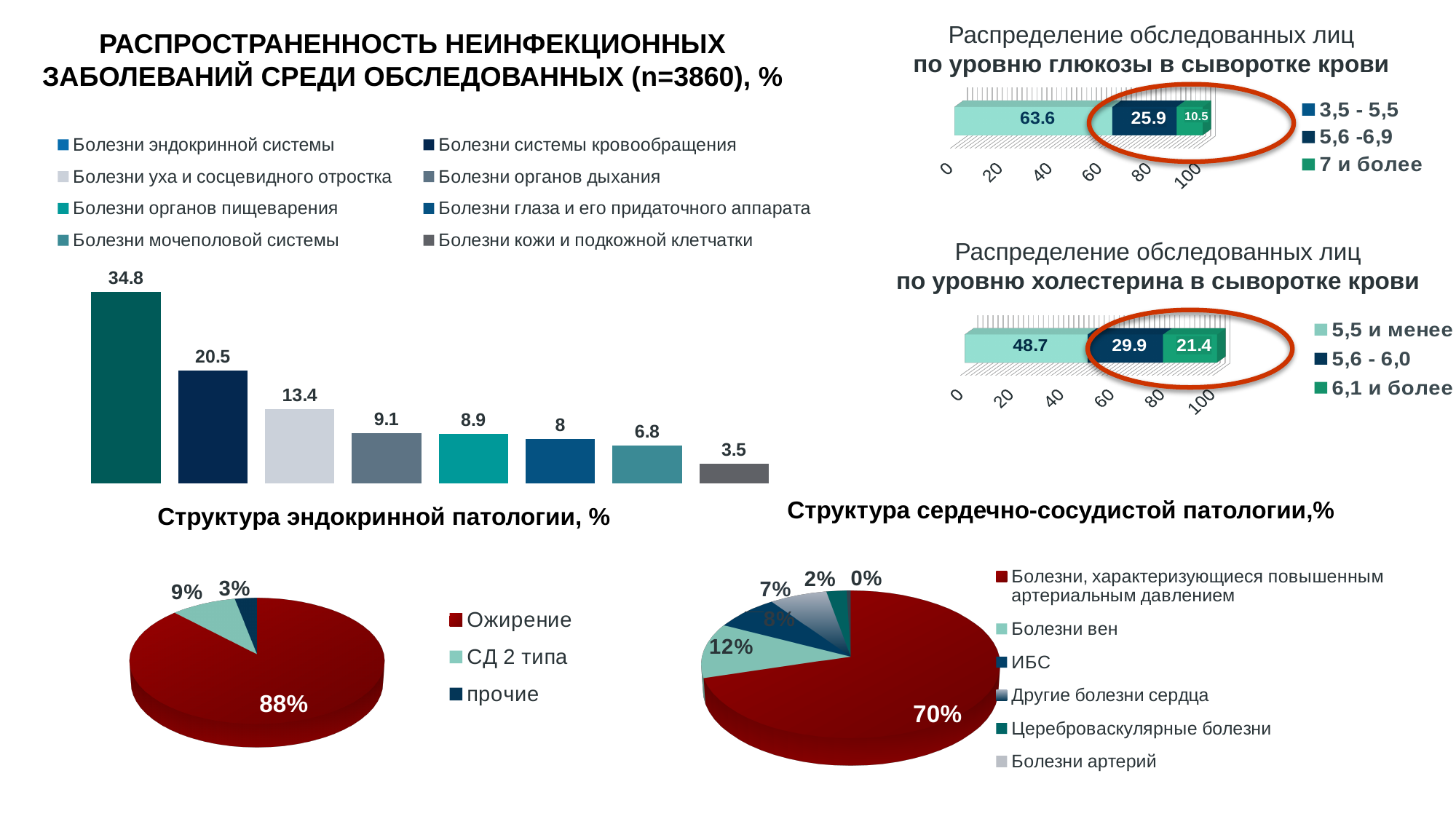
What kind of chart is 'Структура сердечно-сосудистой патологии,%'? Pie chart In the chart 'Распределение обследованных лиц по уровню глюкозы в сыворотке крови', what is the value for the 3,5 - 5,5 group? 63.6 In the bar chart 'Распространенность неинфекционных заболеваний среди обследованных', what is the value for Болезни системы кровообращения? 20.5 In the bar chart 'Распространенность неинфекционных заболеваний среди обследованных', what is the highest value shown? 34.8 In the chart 'Распределение обследованных лиц по уровню холестерина в сыворотке крови', how many groups does the legend list? 3 In the pie chart 'Структура сердечно-сосудистой патологии,%', what share does ИБС have? 8% In the pie chart 'Структура эндокринной патологии, %', what share does Ожирение have? 88% In the chart 'Распределение обследованных лиц по уровню глюкозы в сыворотке крови', what is the value for the 7 и более group? 10.5 In the bar chart 'Распространенность неинфекционных заболеваний среди обследованных', what is the value for Болезни кожи и подкожной клетчатки? 3.5 In the bar chart 'Распространенность неинфекционных заболеваний среди обследованных', how many bars are plotted? 8 In the bar chart 'Распространенность неинфекционных заболеваний среди обследованных', what is the difference between the value for Болезни системы кровообращения and the value for Болезни уха и сосцевидного отростка? 7.1 In the chart 'Распределение обследованных лиц по уровню холестерина в сыворотке крови', what is the value for the 5,6 - 6,0 group? 29.9